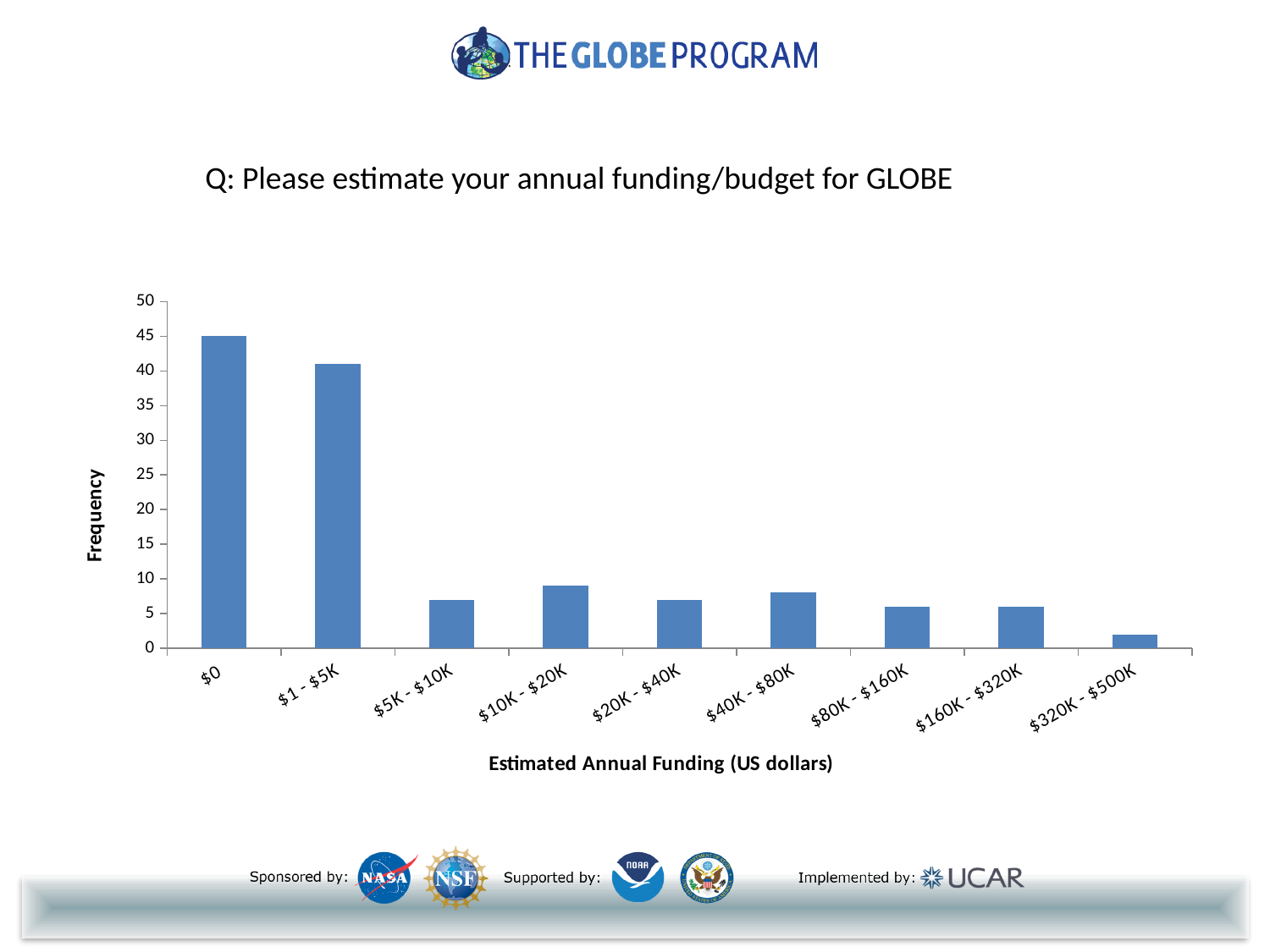
Is the frequency for $5K - $10K greater or less than 10? less Which has a higher frequency, $0 or $1 - $5K? $0 Which has a higher frequency, $10K - $20K or $320K - $500K? $10K - $20K Which funding category has the lowest frequency? $320K - $500K Is the frequency for $1 - $5K greater or less than 40? greater Which funding category has the highest frequency? $0 What is the title of the x axis? Estimated Annual Funding (US dollars) What is the frequency for the $0 category? 45 What kind of chart is shown on the slide? bar chart How many funding categories are shown on the x axis? 9 Is the frequency for $40K - $80K greater or less than 10? less